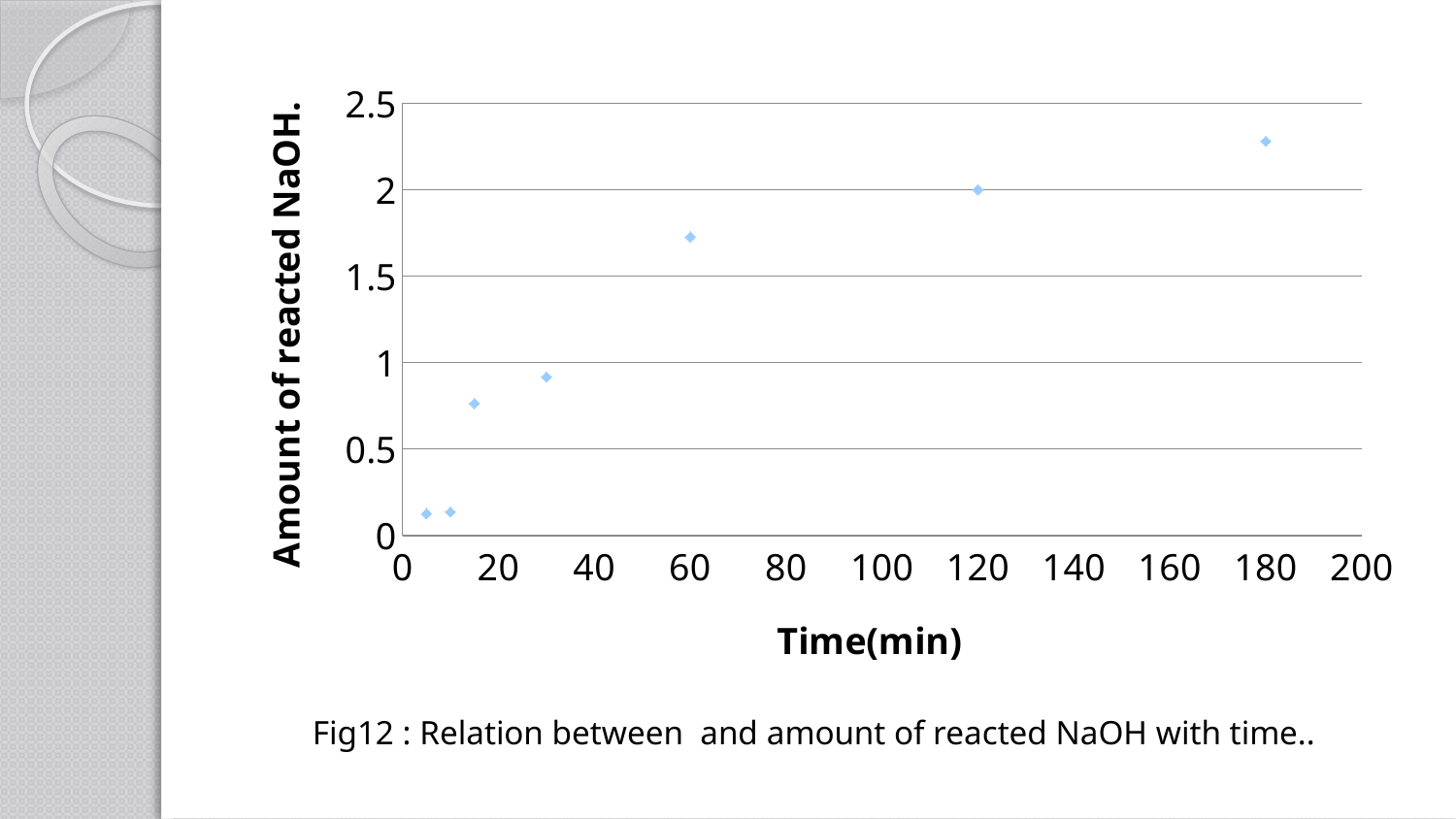
What kind of chart is shown on the slide? scatter chart Do the values generally rise or fall as time increases along the x axis? rise At which time (min) is the amount of reacted NaOH highest? 180 What is the title of the y axis? Amount of reacted NaOH. Which has the larger amount of reacted NaOH, 30 min or 60 min? 60 min Is the amount of reacted NaOH at 15 min greater or less than 0.5? greater What is the title of the x axis? Time(min) How many data points are plotted on the chart? 7 Is the amount of reacted NaOH at 60 min greater or less than 1.5? greater Is the amount of reacted NaOH at 180 min greater or less than 2? greater Which has the larger amount of reacted NaOH, 120 min or 180 min? 180 min